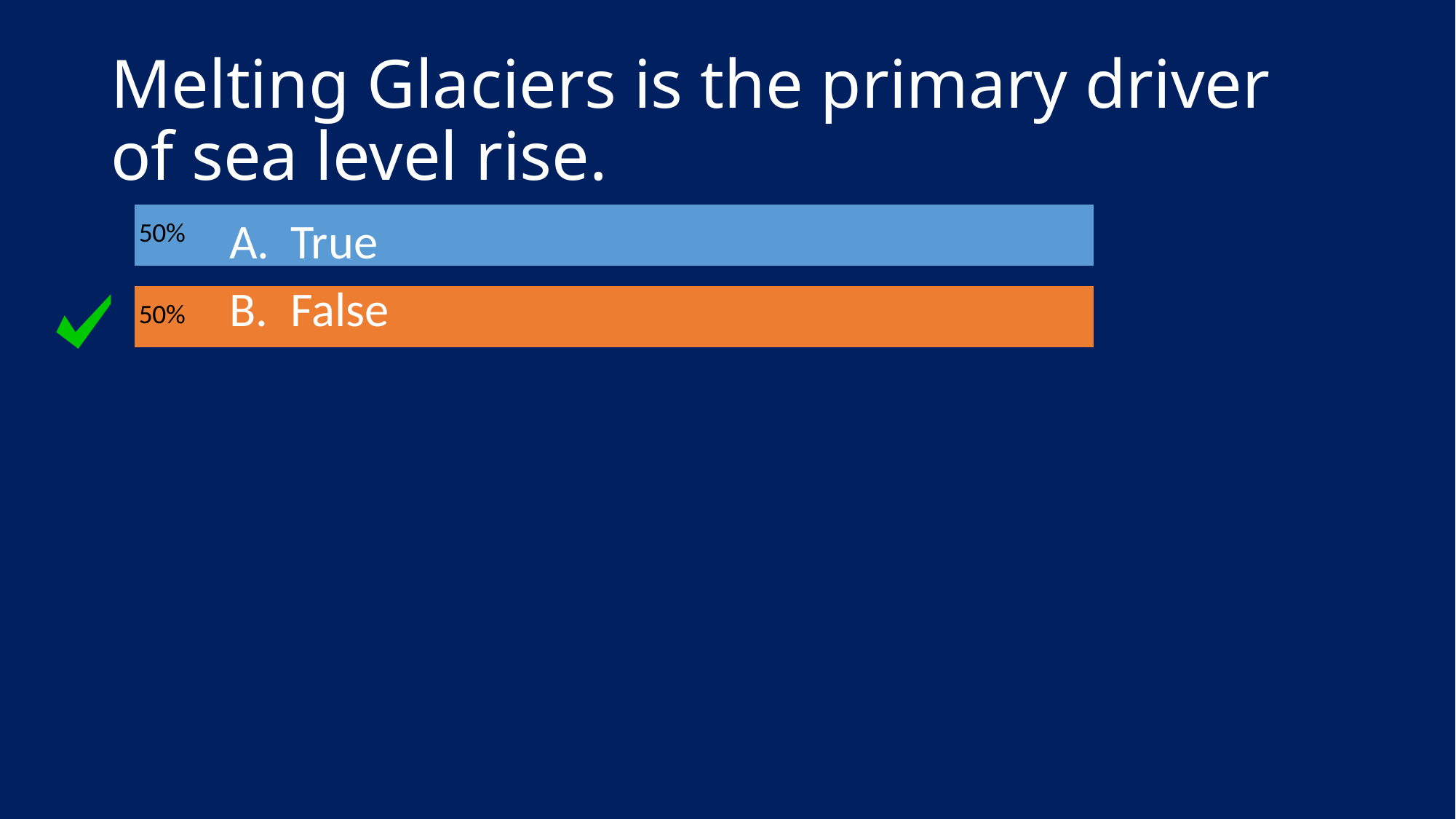
What kind of chart is used to show the poll results? bar chart What colour is the bar for option B, False? orange What percentage of responses chose option B, False? 50% How many answer options (bars) are shown on the chart? 2 What is the combined percentage of the True and False bars? 100% What is the difference between the percentage for True and the percentage for False? 0% Which answer option is marked with a green check mark as correct? B. False What percentage of responses chose option A, True? 50%